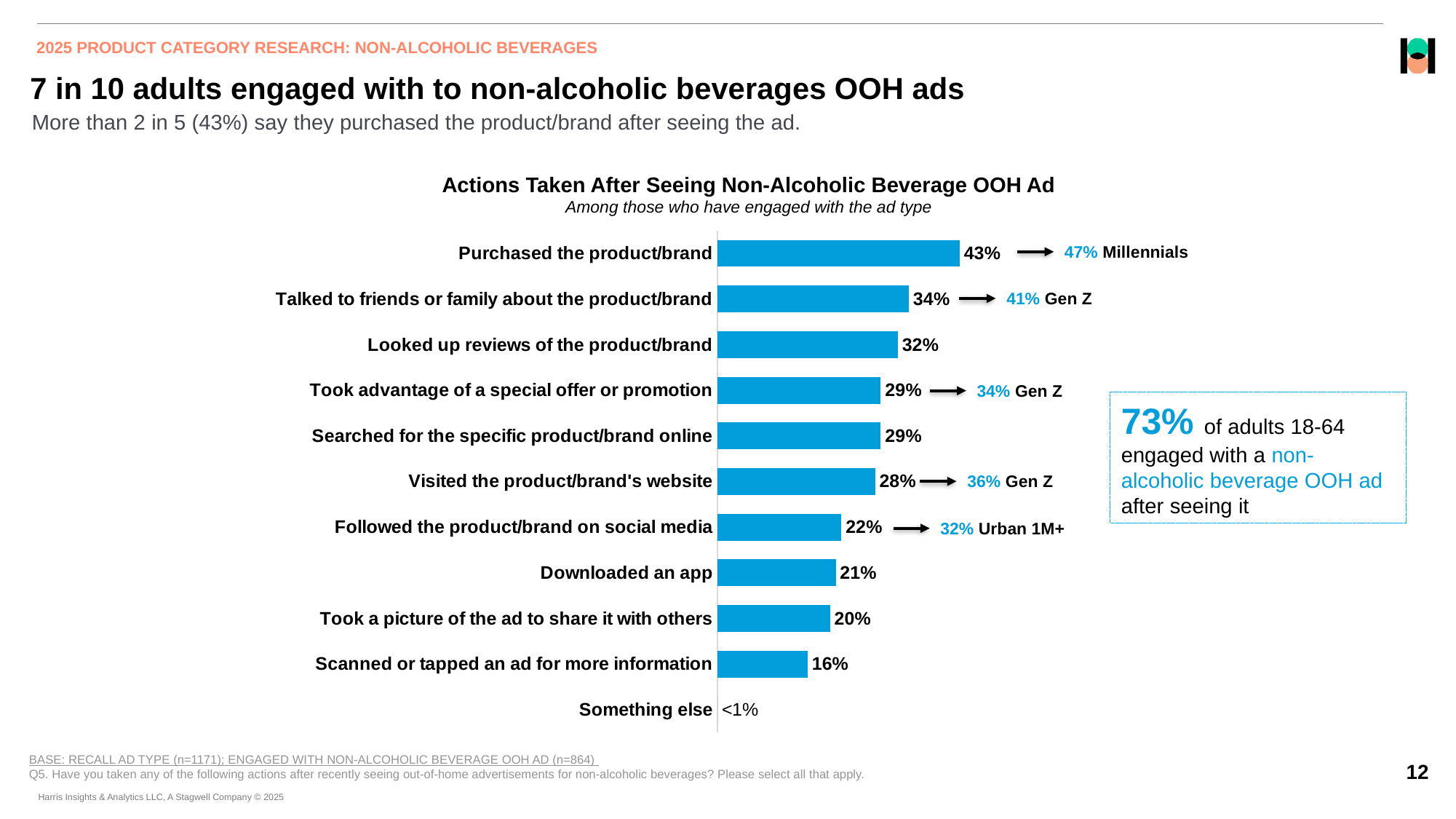
What type of chart is used to show the actions taken after seeing the ad? Bar chart What is the title of the chart? Actions Taken After Seeing Non-Alcoholic Beverage OOH Ad Which action has the highest percentage in the chart? Purchased the product/brand Which is larger: the percentage who downloaded an app or the percentage who took a picture of the ad to share it with others? Downloaded an app What percentage scanned or tapped an ad for more information? 16% How many action categories are listed in the chart? 11 What is the difference between the percentage who purchased the product/brand and the percentage who looked up reviews of the product/brand? 11% Which action has the lowest percentage in the chart? Something else What value is shown for 'Something else'? <1% What percentage talked to friends or family about the product/brand? 34% What percentage of Millennials purchased the product/brand, according to the callout next to the top bar? 47% What percentage purchased the product/brand after seeing the non-alcoholic beverage OOH ad? 43%